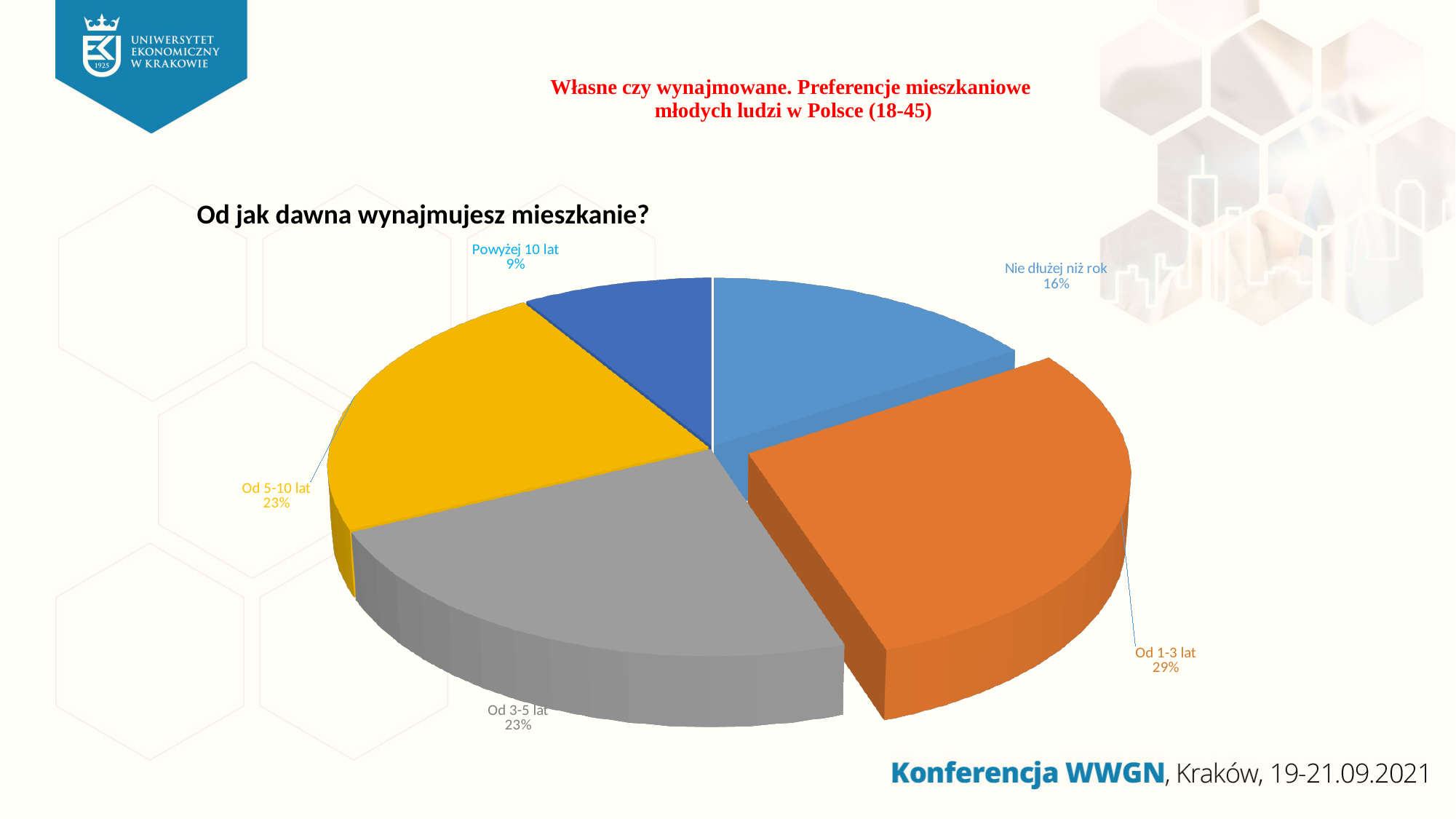
What share of the pie is labelled "Od 5-10 lat"? 23% What is the title of the chart? Od jak dawna wynajmujesz mieszkanie? Which is larger, the share for "Nie dłużej niż rok" or the share for "Od 3-5 lat"? Od 3-5 lat What is the difference in percentage points between "Od 1-3 lat" and "Nie dłużej niż rok"? 13 What share of the pie is labelled "Nie dłużej niż rok"? 16% What share of the pie is labelled "Od 1-3 lat"? 29% How many slices does the pie chart have? 5 What colour is the slice for "Od 1-3 lat"? orange Which category has the smallest share of the pie? Powyżej 10 lat Which category has the largest share of the pie? Od 1-3 lat What kind of chart is shown on the slide? pie chart